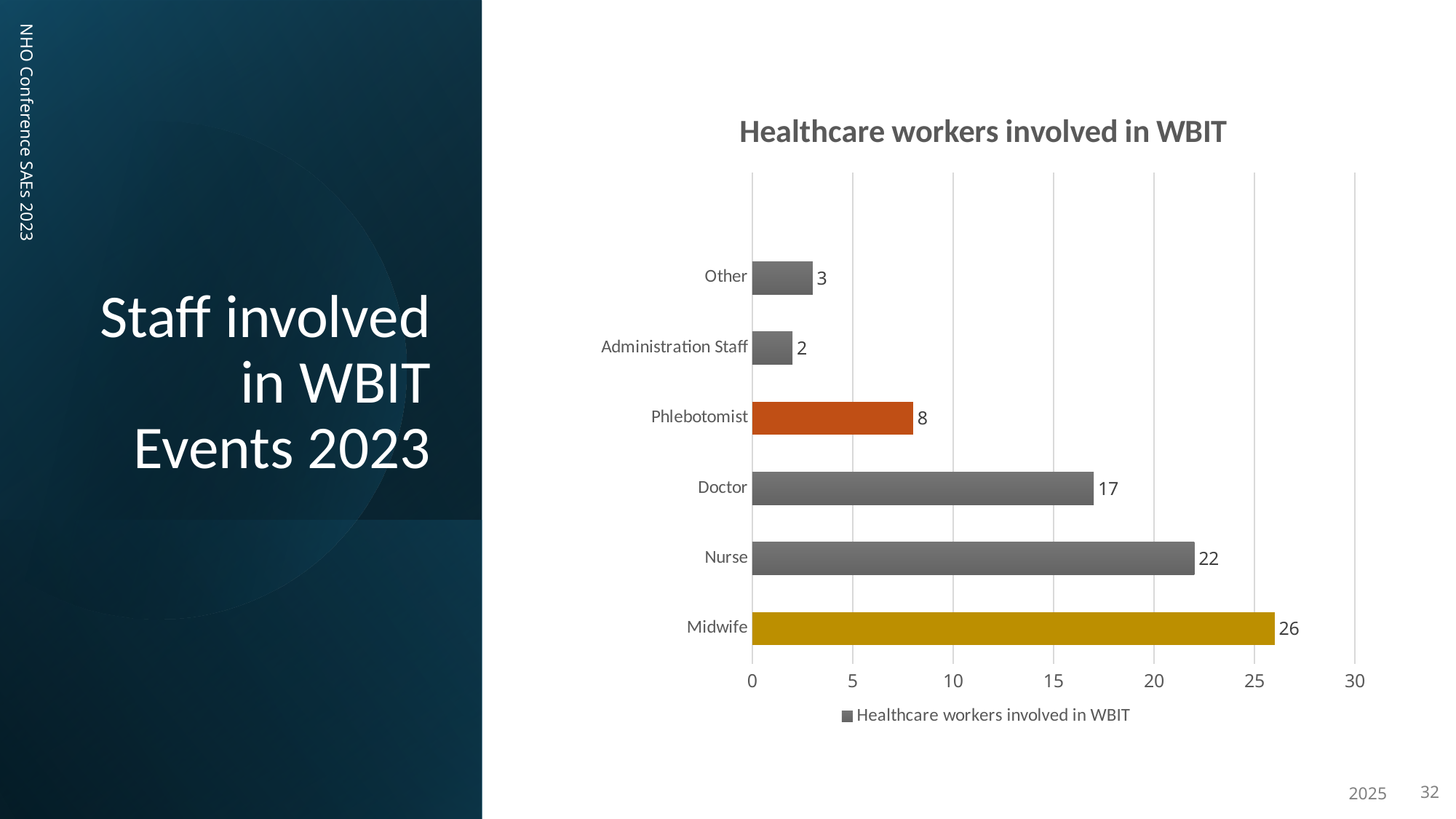
Which is larger, the value for Doctor or the value for Phlebotomist? Doctor What is the title of the chart? Healthcare workers involved in WBIT What is the value for Administration Staff? 2 What kind of chart is shown? bar chart Which category has the lowest value? Administration Staff What is the difference between the values for Nurse and Doctor? 5 How many series does the legend list? 1 What is the value for Midwife? 26 Which category has the highest value? Midwife Is the value for Nurse greater or less than 20? greater What is the value for Phlebotomist? 8 How many categories are shown in the chart? 6